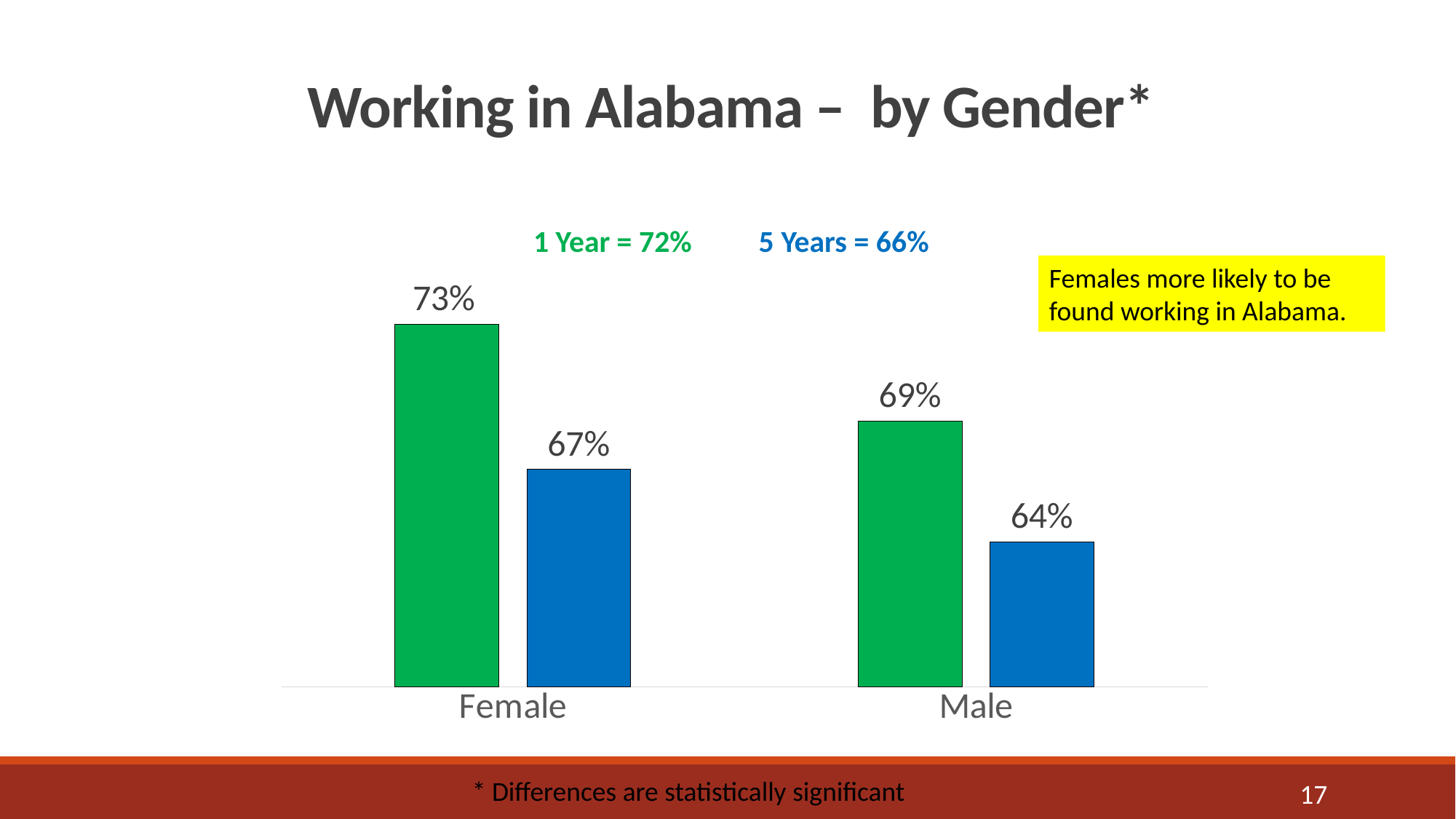
What is the 5 Years value for Female? 67% What is the 1 Year value for Female? 73% What type of chart is shown on the slide? bar chart What is the difference between the 1 Year and 5 Years values for Female? 6 percentage points Which bar shows the lowest value on the chart? Male, 5 Years (64%) What is the difference between the Female and Male 1 Year values? 4 percentage points What is the 1 Year value for Male? 69% What overall 1 Year and 5 Years percentages are shown above the chart? 1 Year = 72%, 5 Years = 66% What is the 5 Years value for Male? 64% How many gender categories are shown on the x axis? 2 Is the 5 Years value for Female larger or smaller than the 1 Year value for Male? smaller Which gender has the higher 1 Year value? Female